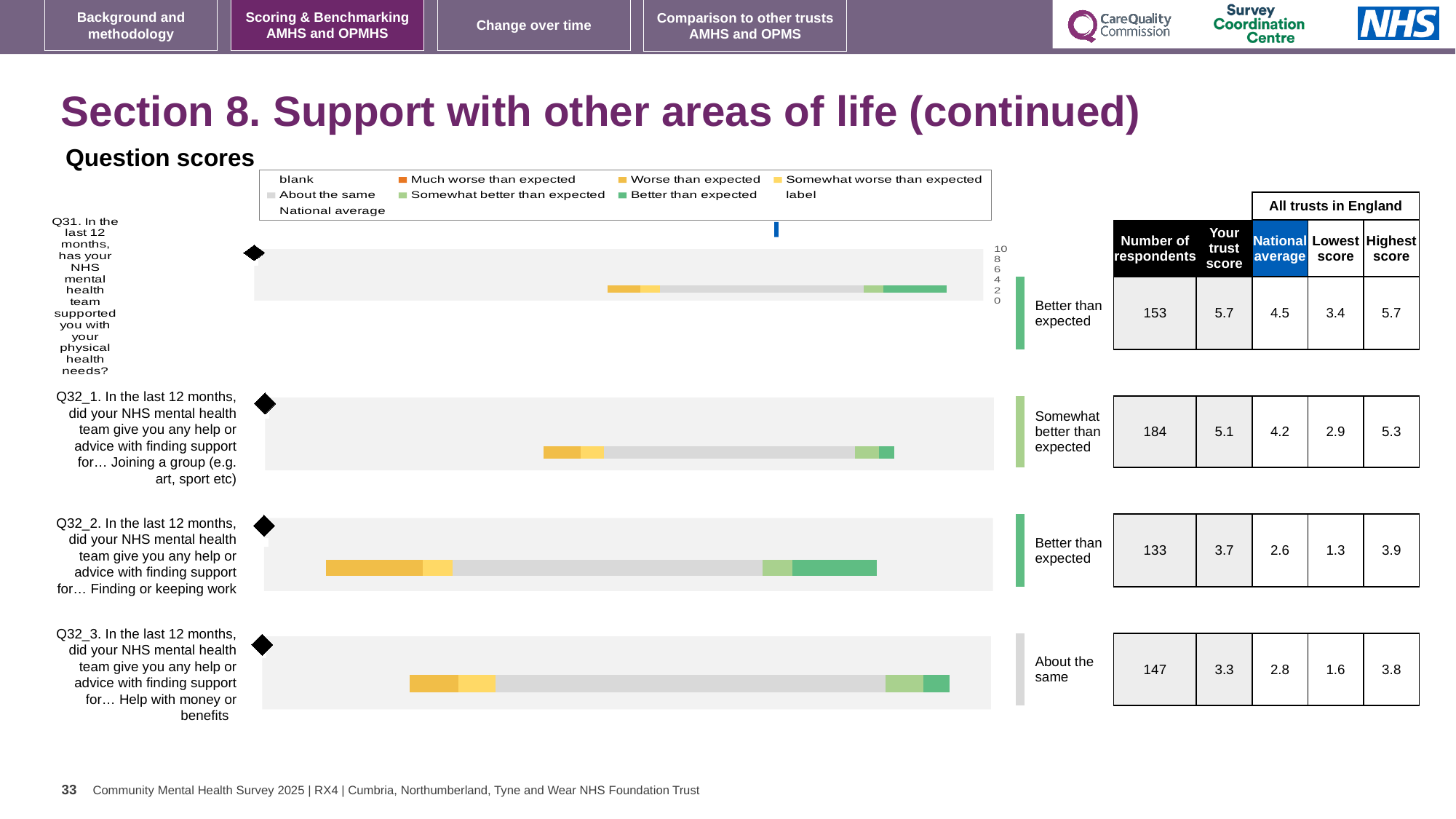
Which question has the lowest trust score? Q32_3 In the question scores chart legend, which colour represents 'Much worse than expected'? orange What is the national average for Q31 (support with physical health needs)? 4.5 What is the highest score among all trusts in England for Q32_3 (Help with money or benefits)? 3.8 What is the difference between the trust score and the national average for Q32_2? 1.1 How many respondents answered Q32_1 (Joining a group)? 184 In the question scores chart legend, what does the grey colour represent? About the same Which benchmark category is Q32_3 (Help with money or benefits) placed in? About the same What is the trust score for Q32_2 (Finding or keeping work)? 3.7 What kind of chart is used to show the question scores on this slide? bar chart Which question has the highest trust score? Q31 How many questions (bars) are plotted in the question scores chart? 4